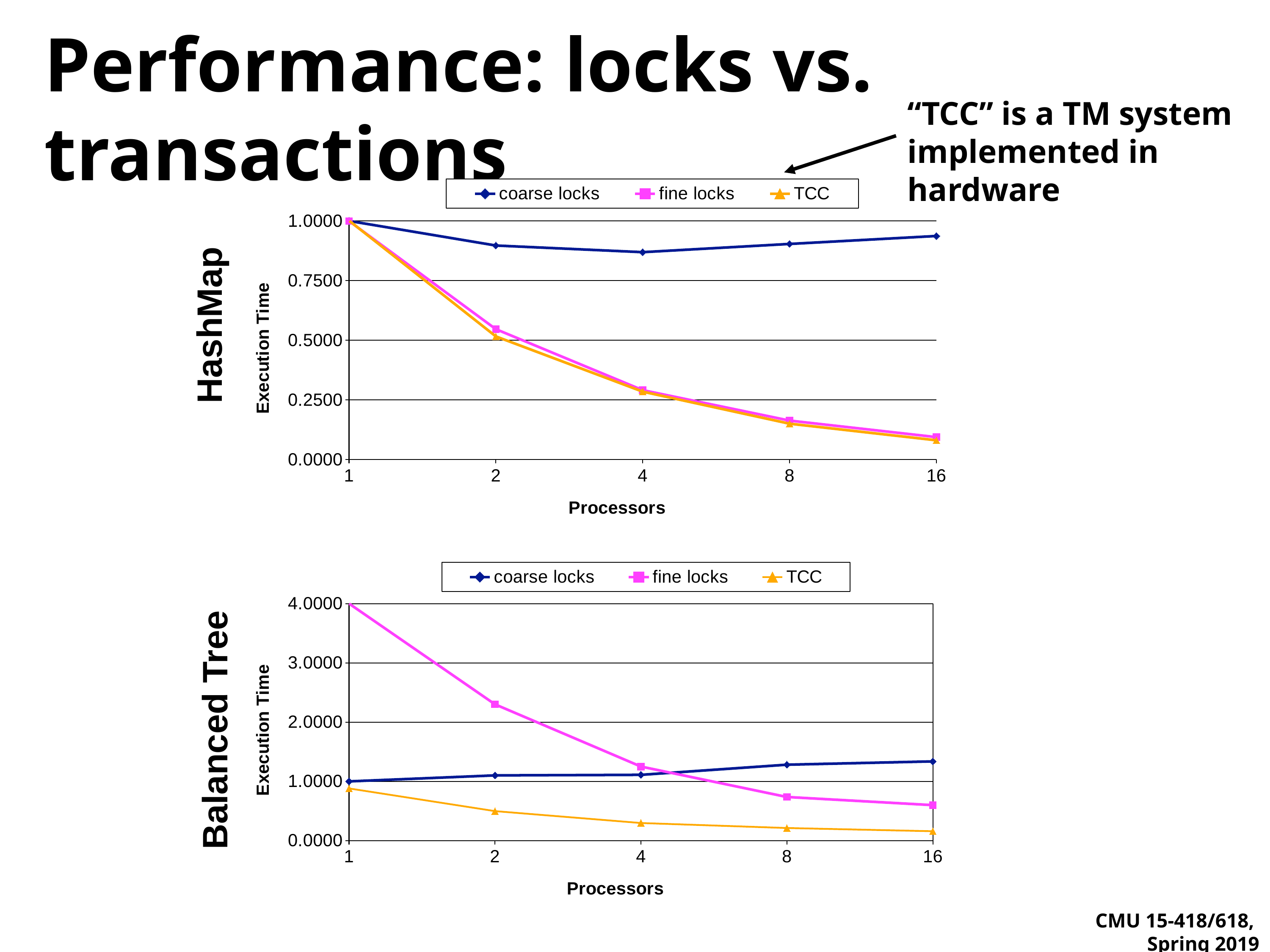
In the HashMap chart, is the value for TCC at 16 processors greater or less than 0.2500? less How many processor counts are plotted along the x axis of the HashMap chart? 5 In the Balanced Tree chart, is the value for fine locks at 4 processors greater or less than 1.0000? greater How many series does the legend of the Balanced Tree chart list? 3 What kind of chart is the HashMap chart? line chart In the Balanced Tree chart, which is larger at 2 processors: fine locks or TCC? fine locks In the HashMap chart, what is the execution time for coarse locks at 1 processor? 1.0000 In the Balanced Tree chart, does the coarse locks series rise or fall as the number of processors increases? rise In the HashMap chart, is the value for coarse locks at 16 processors greater or less than 0.7500? greater In the Balanced Tree chart, what is the execution time for fine locks at 1 processor? 4.0000 In the HashMap chart, does the fine locks series rise or fall as the number of processors increases? fall In the Balanced Tree chart, which series has the lowest execution time at 16 processors? TCC